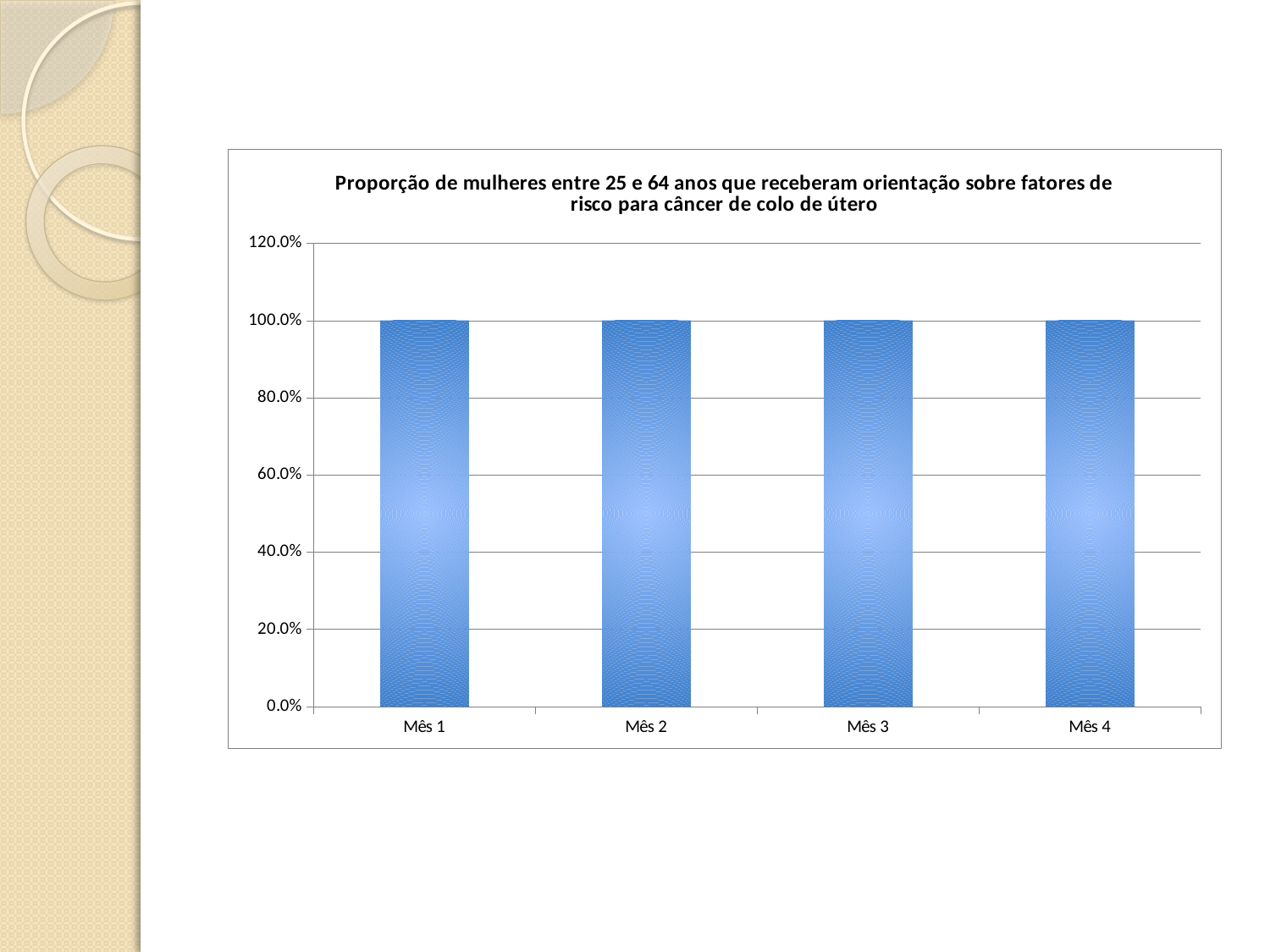
What kind of chart is shown on the slide? bar chart What is the difference between the values for Mês 1 and Mês 3? 0.0% Do the values rise, fall, or stay flat from Mês 1 to Mês 4? stay flat Is the value for Mês 2 greater or less than 80.0%? greater Is the value for Mês 4 greater or less than 120.0%? less What is the value for Mês 2? 100.0% What is the value for Mês 3? 100.0% How many categories are plotted on the x axis of the chart? 4 What is the value for Mês 1? 100.0% What is the label of the first category on the x axis? Mês 1 What is the highest value shown on the vertical axis of the chart? 120.0% What is the value for Mês 4? 100.0%